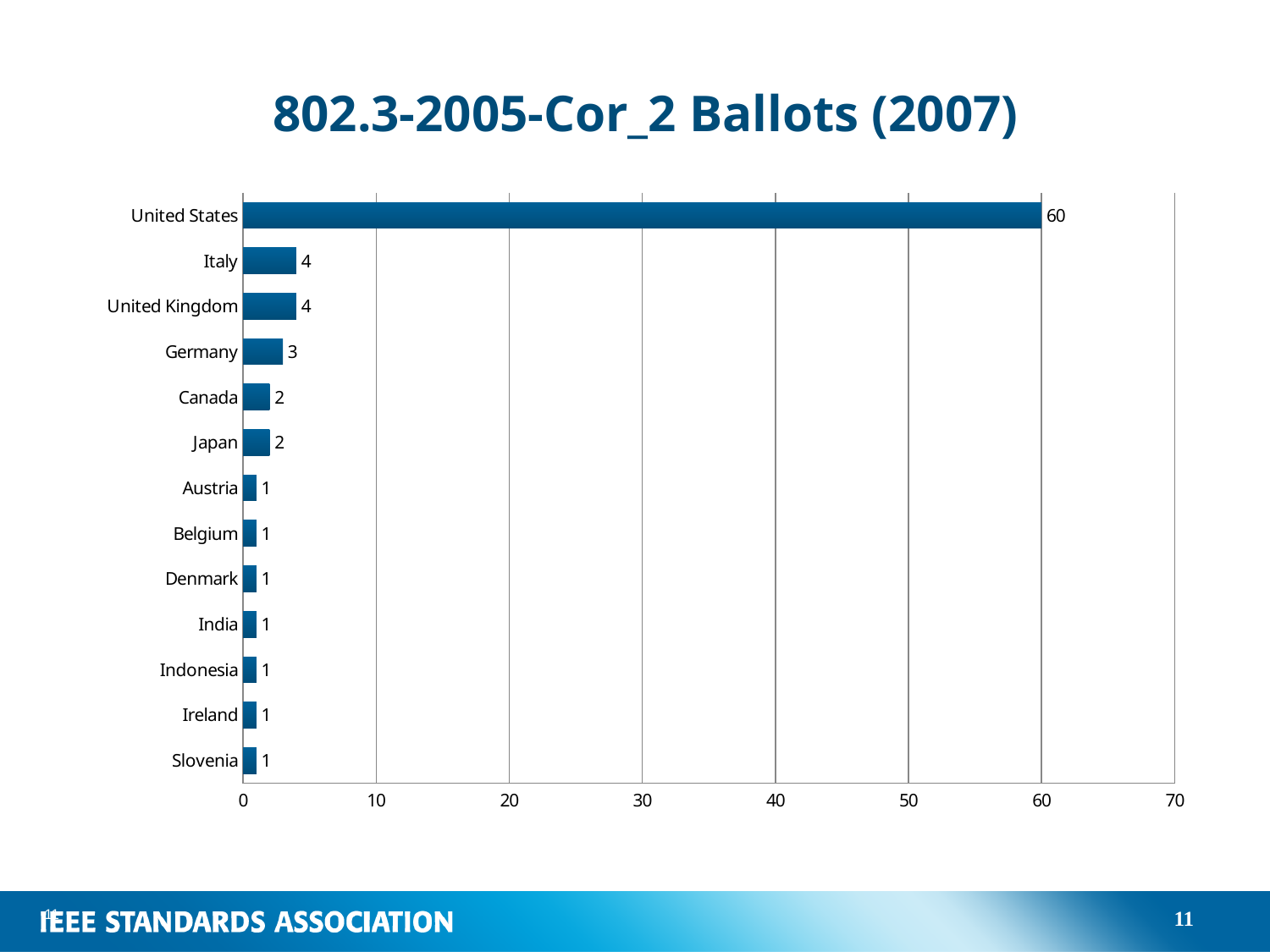
What kind of chart is shown on the slide? bar chart What is the difference between the values for United States and Italy? 56 Which is larger, the value for United Kingdom or the value for Germany? United Kingdom Is the value for United States greater or less than 50? greater What is the difference between the values for Germany and Canada? 1 What is the value for Germany? 3 What is the value for United States? 60 How many countries are shown in the chart? 13 What is the highest value shown on the horizontal axis? 70 What is the title of the chart? 802.3-2005-Cor_2 Ballots (2007) Which country has the highest value? United States What is the value for Japan? 2